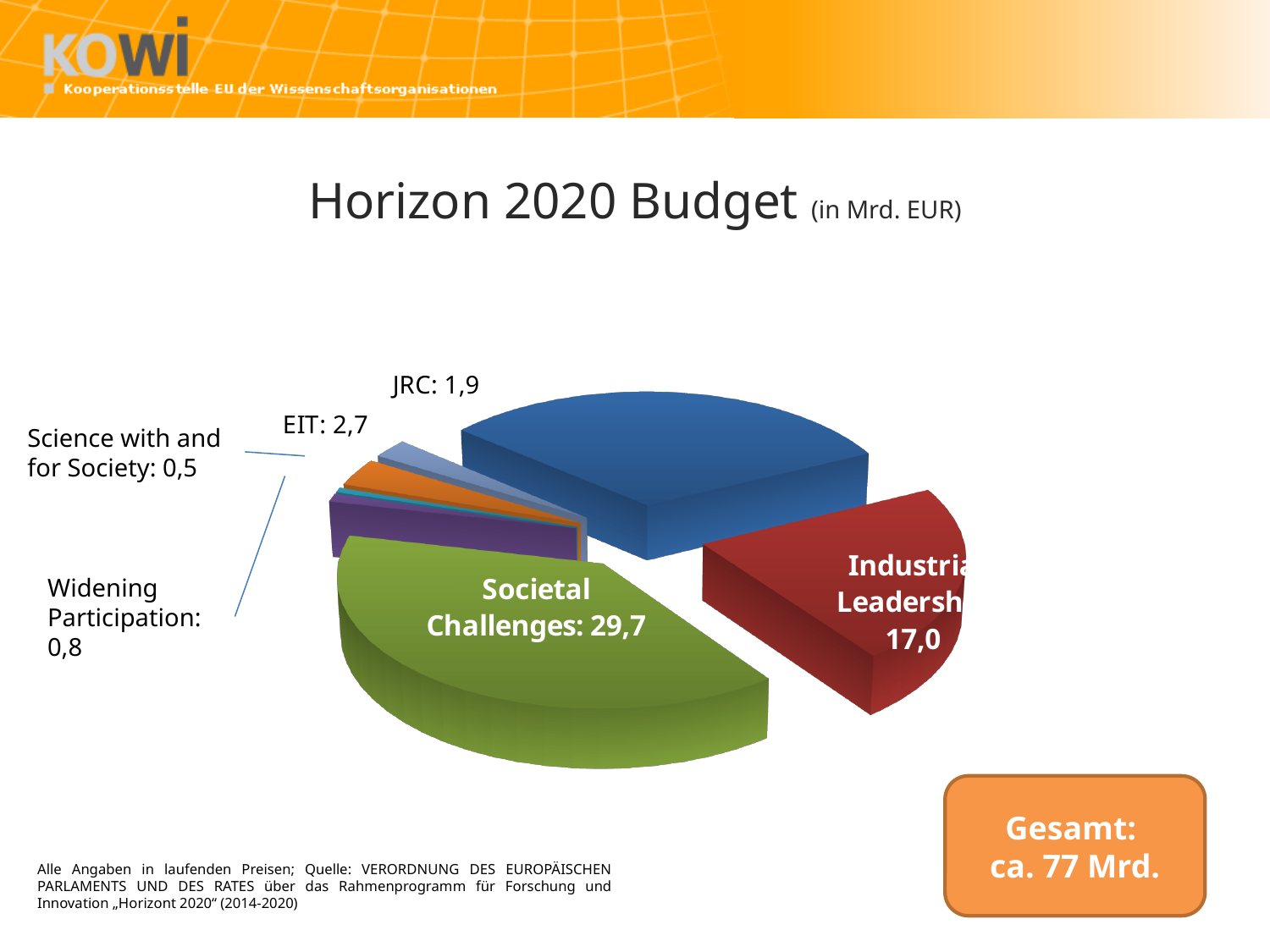
What is the budget value for Science with and for Society? 0,5 What is the budget value for JRC? 1,9 Which of the labelled slices has the smallest value? Science with and for Society What is the budget value for Societal Challenges? 29,7 What is the difference between the values for Widening Participation and Science with and for Society? 0,3 In what unit are the values in the chart given, according to the title? Mrd. EUR What is the difference between the values for Societal Challenges and Industrial Leadership? 12,7 Which is larger, the value for EIT or the value for JRC? EIT What is the budget value for Widening Participation? 0,8 What is the budget value for Industrial Leadership? 17,0 What is the budget value for EIT? 2,7 What kind of chart is shown on the slide? pie chart